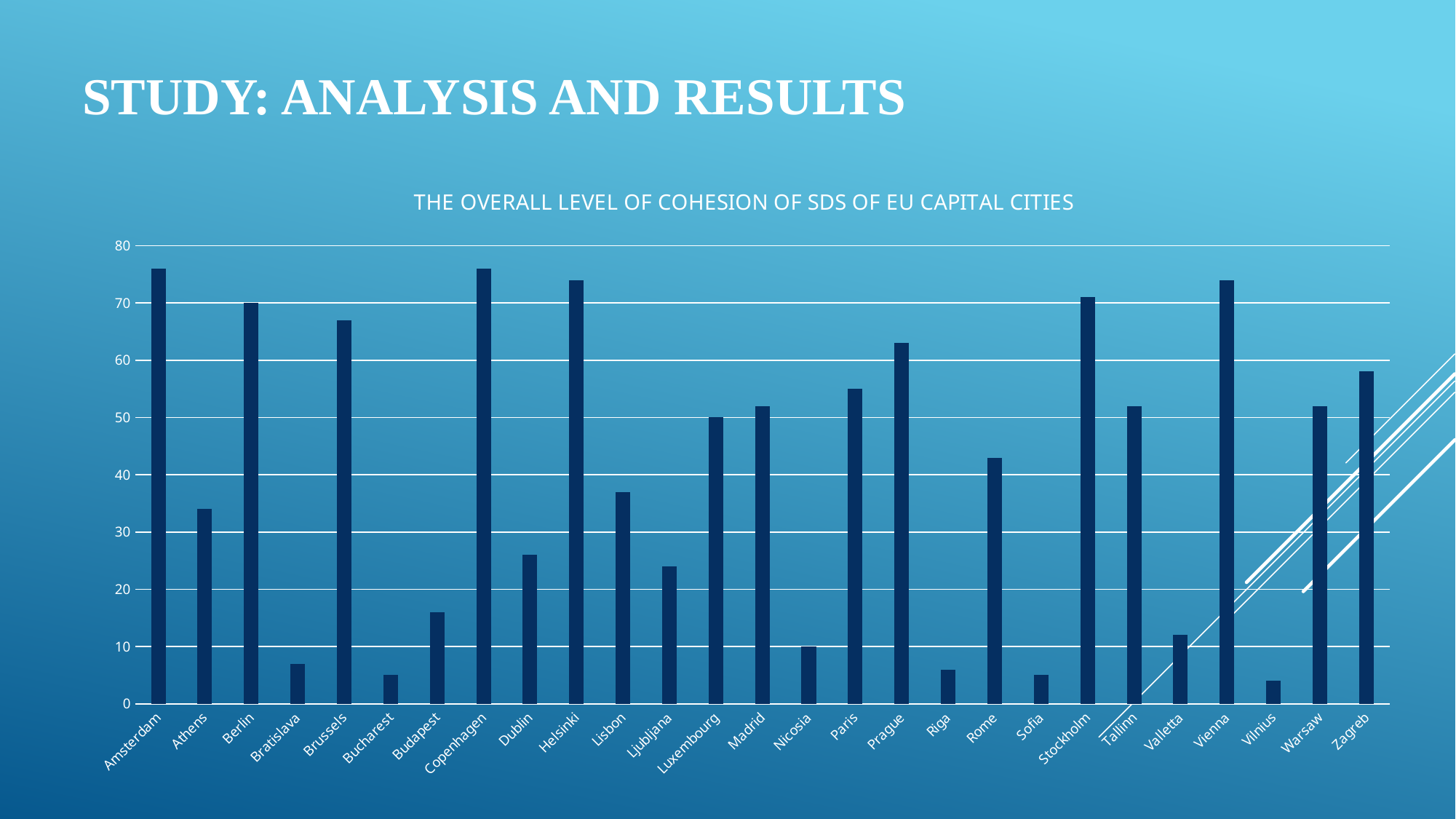
Which has the larger value, Rome or Riga? Rome What is the value for Berlin? 70 Is the value for Vienna greater or less than 70? greater What is the title of the chart? THE OVERALL LEVEL OF COHESION OF SDS OF EU CAPITAL CITIES Is the value for Bratislava greater or less than 10? less How many capital cities are shown on the x axis of the chart? 27 Is the value for Dublin greater or less than 30? less What is the value for Luxembourg? 50 What kind of chart is shown on the slide? bar chart Which has the larger value, Helsinki or Lisbon? Helsinki